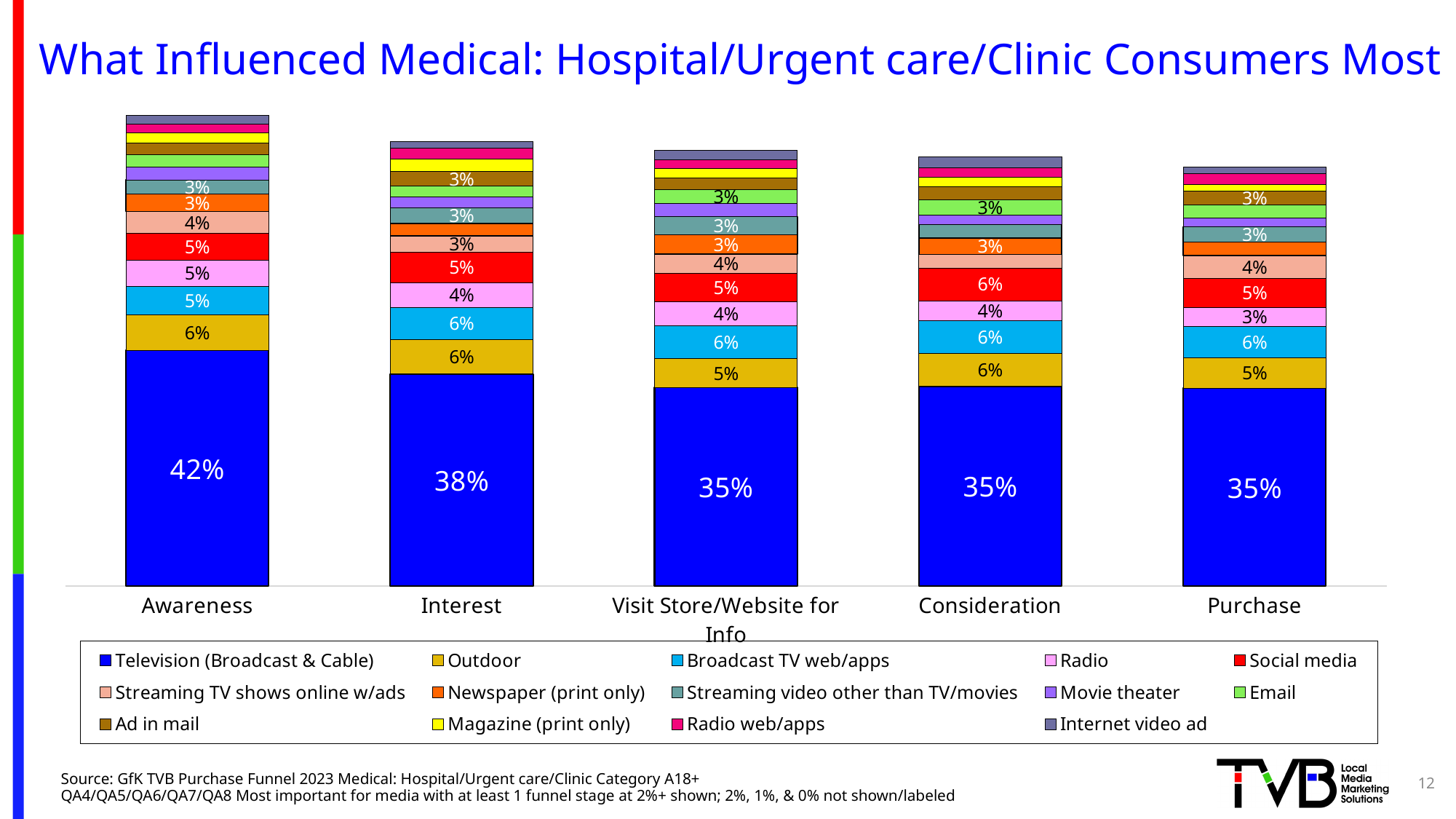
Which funnel stage has the highest Television (Broadcast & Cable) value? Awareness How many funnel stages (categories) are shown on the x axis? 5 What is the difference between the Television (Broadcast & Cable) values for Awareness and Interest? 4 percentage points What is the Broadcast TV web/apps value for Interest? 6% Which is larger, the Radio value for Awareness or the Radio value for Purchase? Awareness Does the Television (Broadcast & Cable) value rise or fall from Awareness to Interest? Fall What is the value for Television (Broadcast & Cable) in the Awareness bar? 42% What kind of chart is shown on the slide? Stacked bar chart What is the Social media value for Consideration? 6% Which series forms the bottom (largest) segment of every bar? Television (Broadcast & Cable) What is the Outdoor value for Visit Store/Website for Info? 5% How many series does the legend list? 14